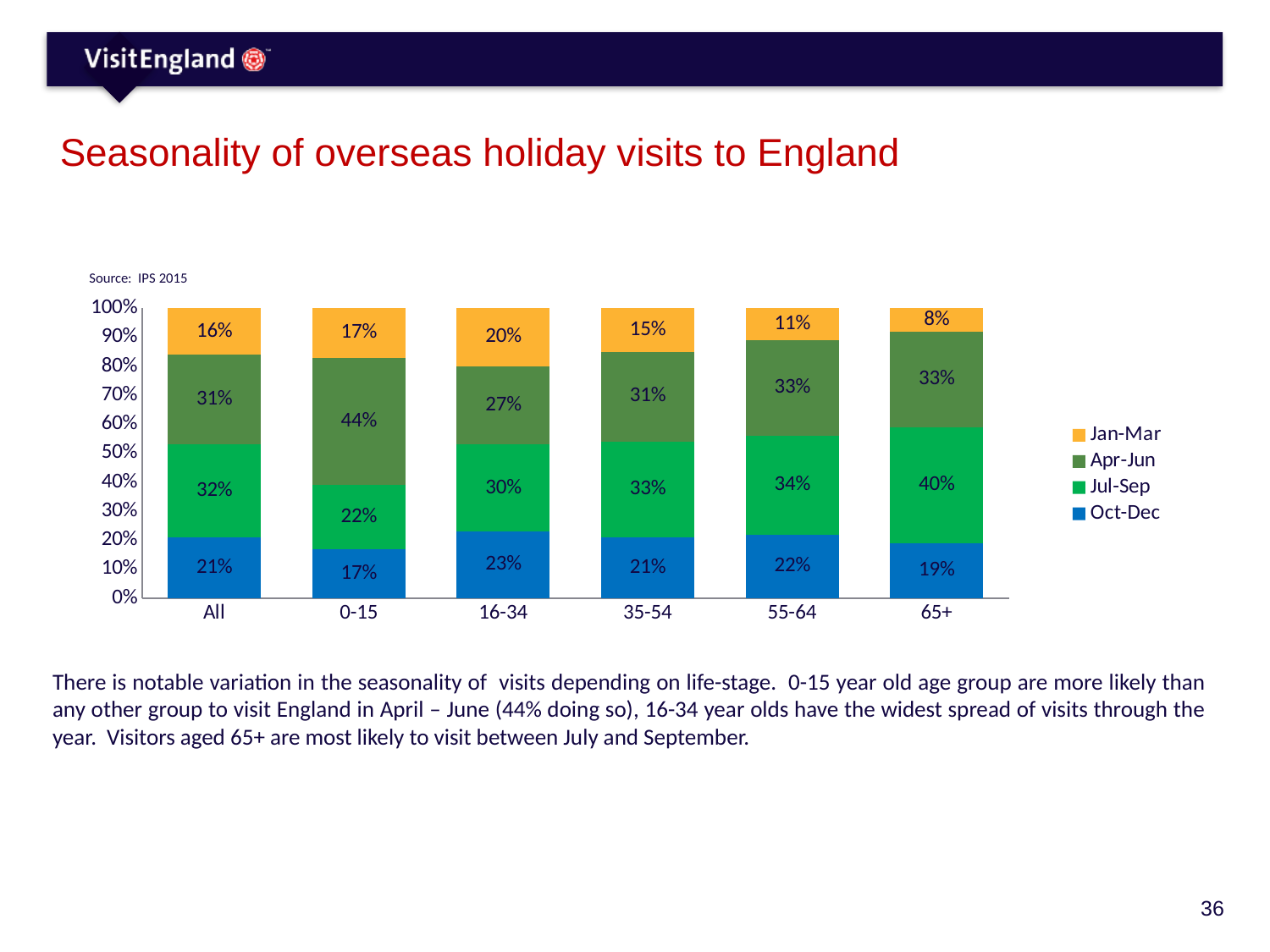
What kind of chart is shown on the slide? Stacked bar chart What is the difference between the Jul-Sep share for 65+ and the Jul-Sep share for 0-15? 18% How many age categories are shown on the x axis? 6 What is the Jul-Sep share for the 65+ age group? 40% Which age group has the highest Apr-Jun share? 0-15 What is the Oct-Dec share for the 16-34 age group? 23% Which series is shown in yellow in the legend? Jan-Mar What is the Apr-Jun share for the 0-15 age group? 44% How many series does the legend list? 4 Which age group has the lowest Jan-Mar share? 65+ What is the Jan-Mar share for the All category? 16% Which is larger: the Jan-Mar share for 16-34 or the Jan-Mar share for 55-64? 16-34